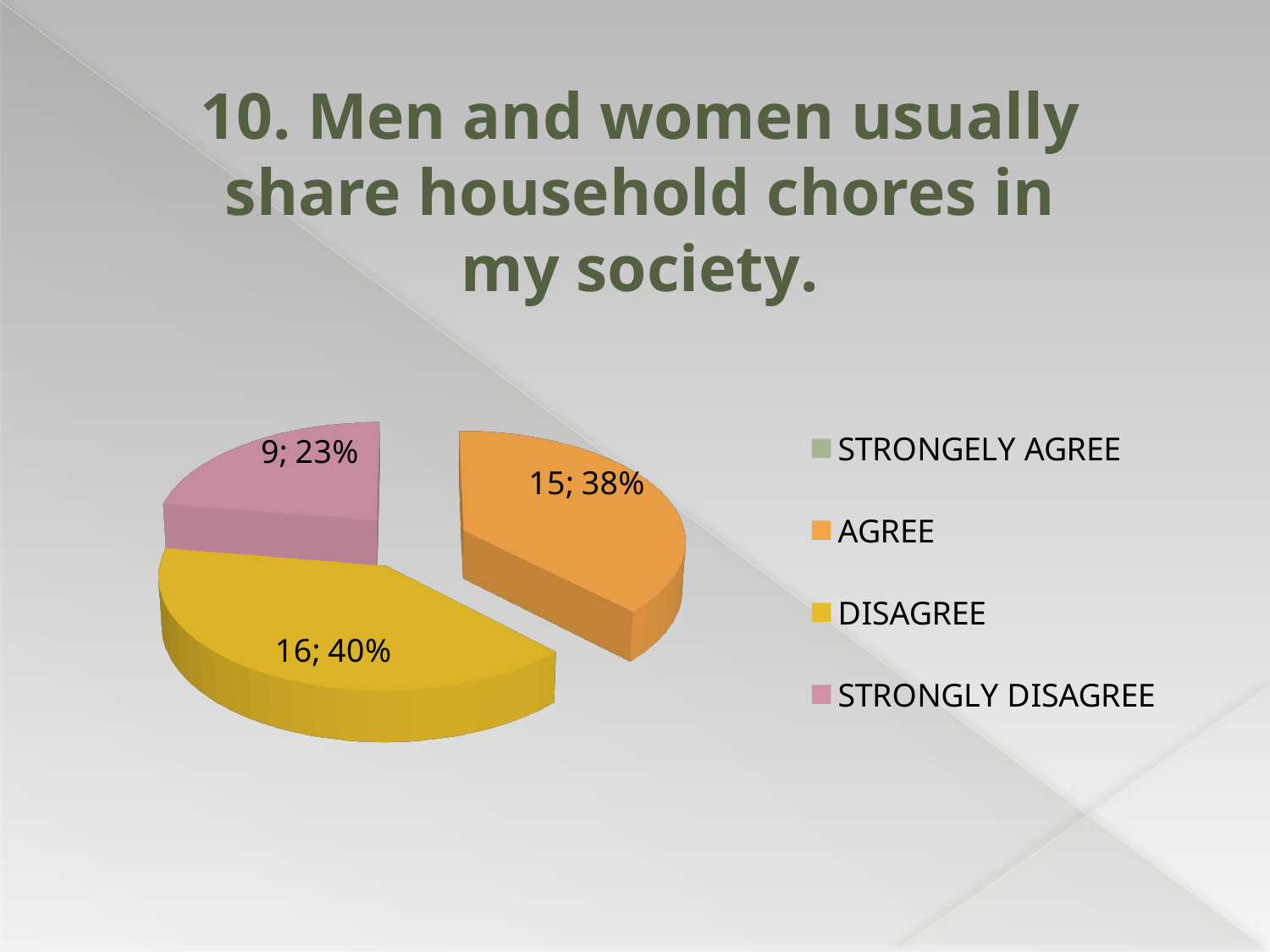
Which is larger, the count for AGREE or the count for DISAGREE? DISAGREE Which category has the largest slice of the pie? DISAGREE What kind of chart is shown on the slide? pie chart What percentage share does DISAGREE have? 40% What percentage share does AGREE have? 38% What is the count for AGREE? 15 How many entries does the legend list? 4 What colour is the DISAGREE slice? yellow What is the difference between the counts for DISAGREE and STRONGLY DISAGREE? 7 What is the count for STRONGLY DISAGREE? 9 What percentage share does STRONGLY DISAGREE have? 23% Which of the visible slices is the smallest? STRONGLY DISAGREE